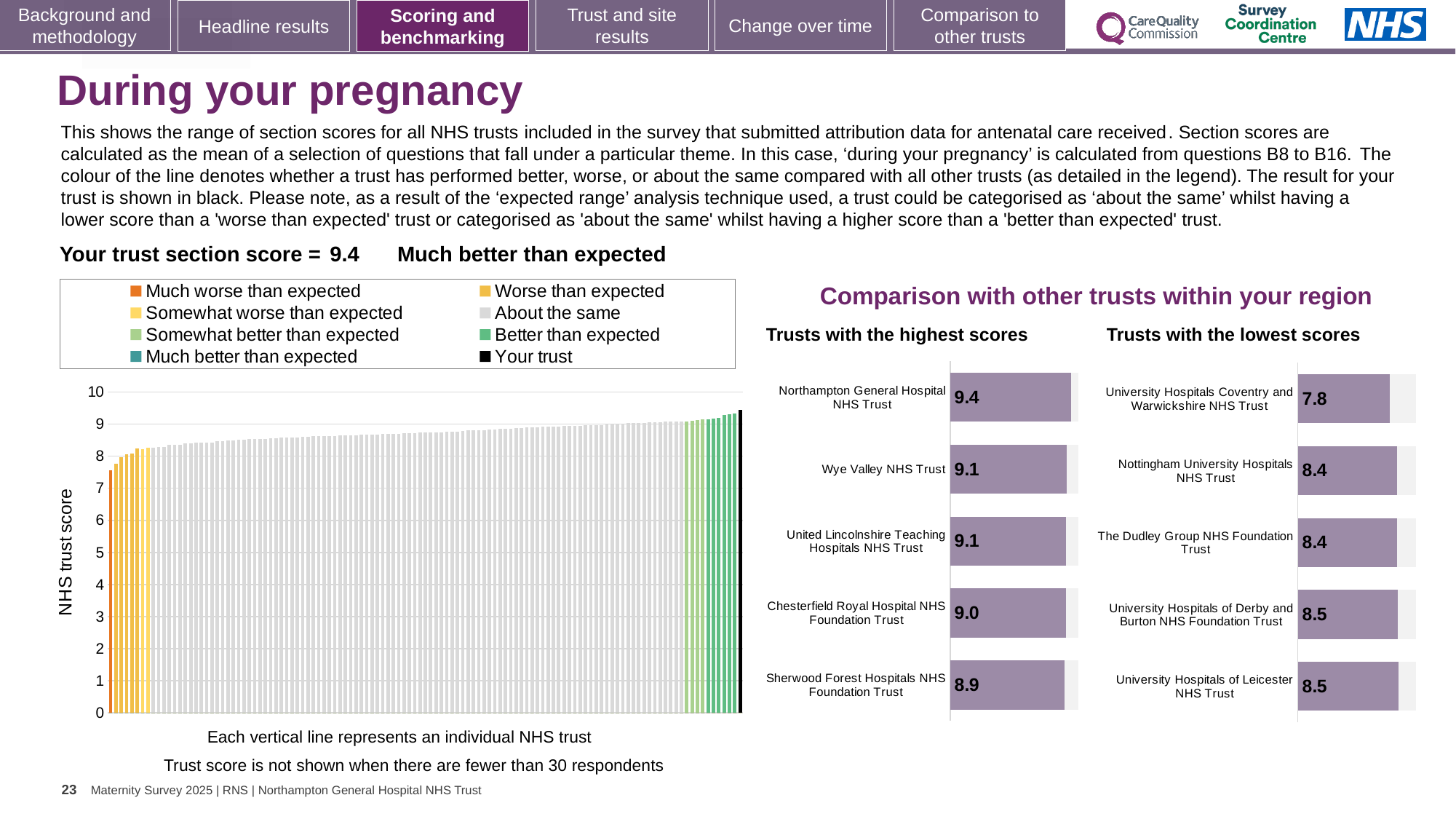
In the 'Trusts with the lowest scores' chart, what is the score for University Hospitals Coventry and Warwickshire NHS Trust? 7.8 In the 'Trusts with the highest scores' chart, what is the score for Wye Valley NHS Trust? 9.1 In the 'Trusts with the highest scores' chart, what is the difference between the scores of Northampton General Hospital NHS Trust and Sherwood Forest Hospitals NHS Foundation Trust? 0.5 How many entries does the legend above the 'NHS trust score' chart list? 8 In the 'NHS trust score' chart on the left, do the values rise or fall from left to right along the x axis? rise Which has the higher score: Chesterfield Royal Hospital NHS Foundation Trust in the highest scores chart or University Hospitals of Derby and Burton NHS Foundation Trust in the lowest scores chart? Chesterfield Royal Hospital NHS Foundation Trust In the 'Trusts with the lowest scores' chart, which trust has the lowest score? University Hospitals Coventry and Warwickshire NHS Trust What kind of chart is the large 'NHS trust score' chart on the left of the slide? bar chart What is the section score for your trust shown on the slide? 9.4 How many trusts are shown in the 'Trusts with the highest scores' chart? 5 In the 'Trusts with the highest scores' chart, which trust has the highest score? Northampton General Hospital NHS Trust In the 'NHS trust score' chart on the left, is the value of the leftmost (orange) bar greater or less than 8? less